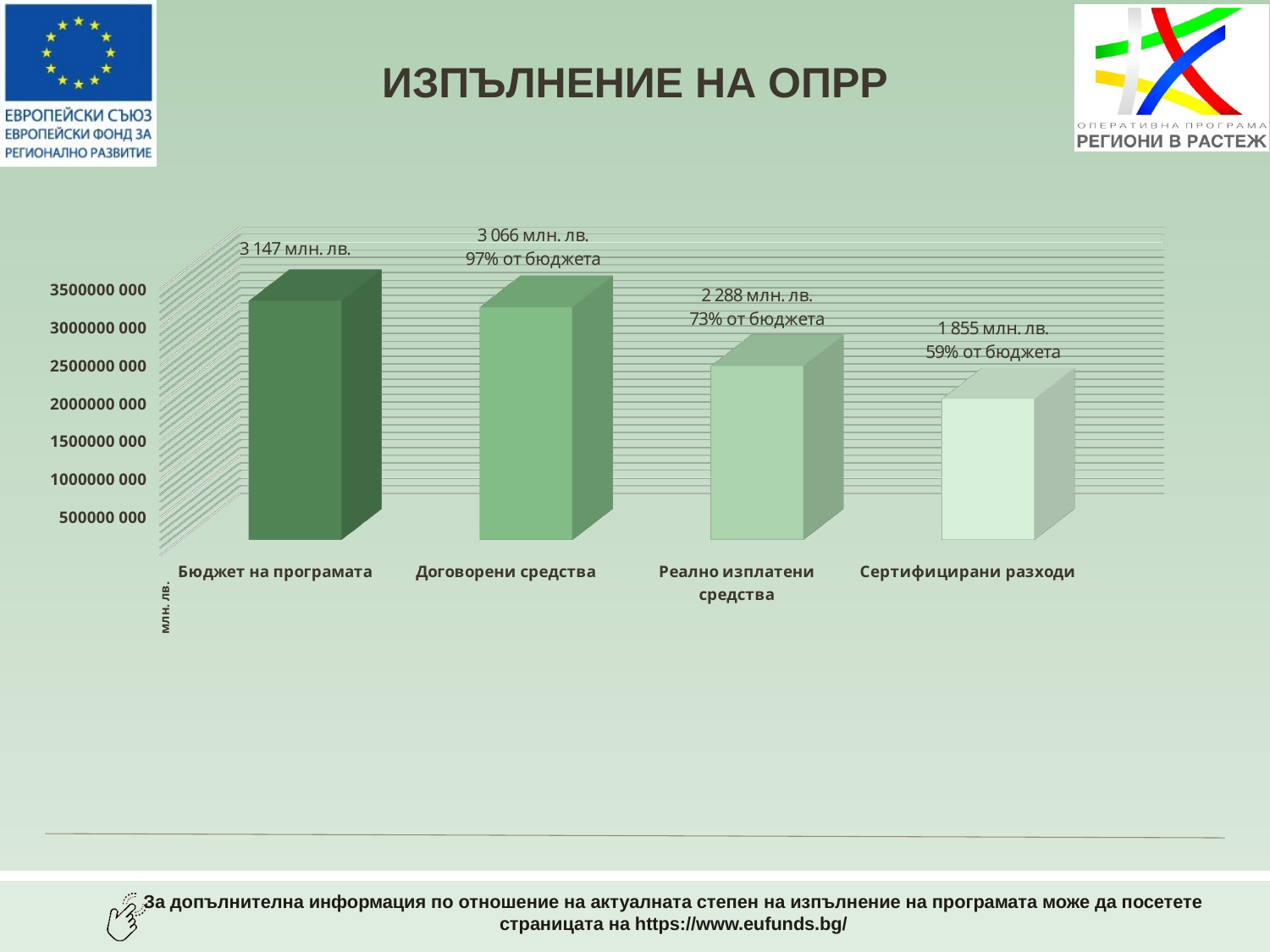
What is the value shown for Сертифицирани разходи? 1 855 млн. лв. What percentage of the budget do Сертифицирани разходи represent according to the data label? 59% от бюджета What is the value shown for Договорени средства? 3 066 млн. лв. Do the values rise or fall from left to right across the categories? Fall Which category has the highest value? Бюджет на програмата What is the value shown for Реално изплатени средства? 2 288 млн. лв. What type of chart is shown on the slide? Bar chart What is the difference between Бюджет на програмата and Договорени средства? 81 млн. лв. Which is larger: Реално изплатени средства or Сертифицирани разходи? Реално изплатени средства How many categories are shown in the chart? 4 Which category has the lowest value? Сертифицирани разходи What is the value shown for Бюджет на програмата? 3 147 млн. лв.